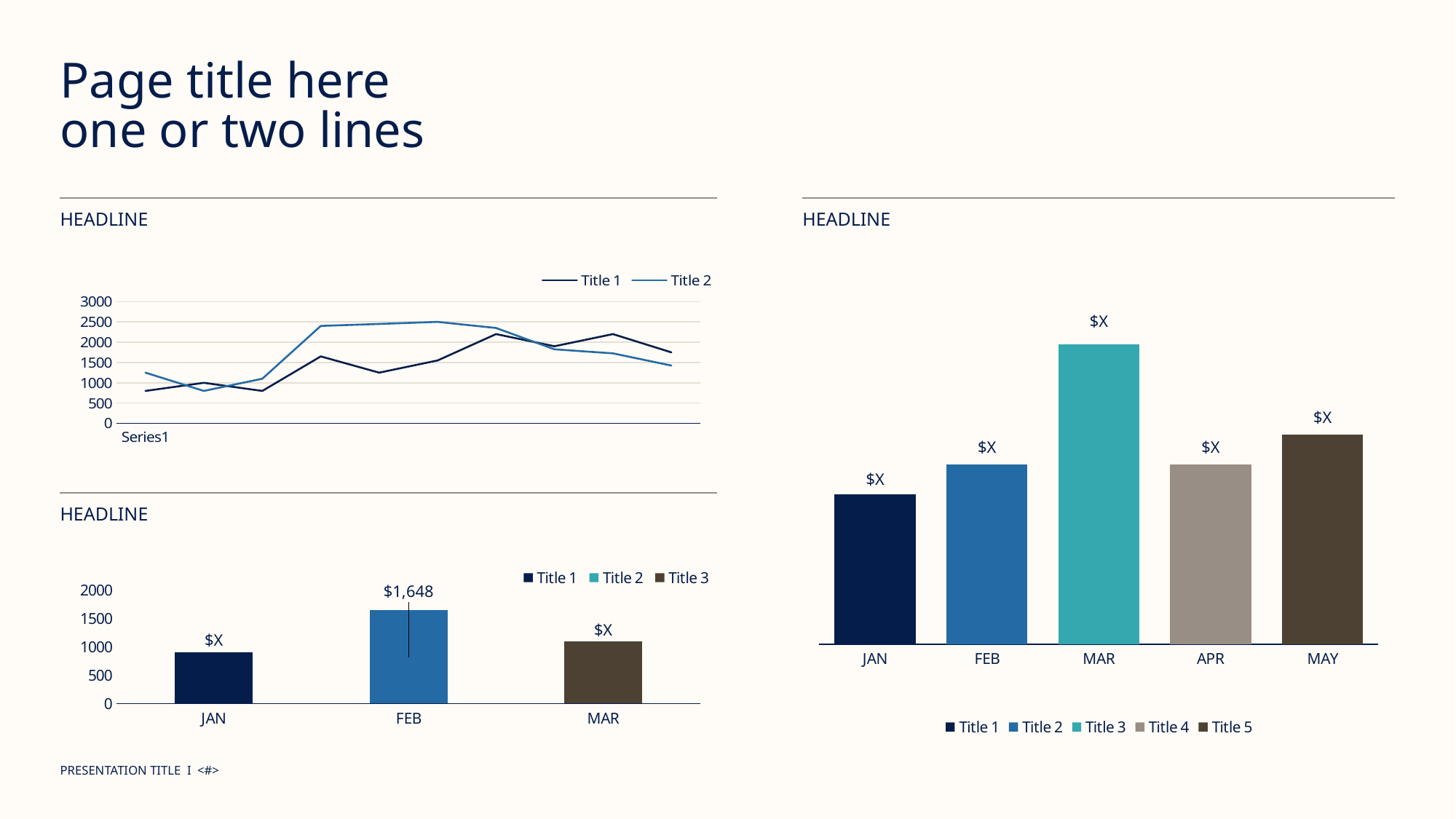
In the bottom-left bar chart, which category has the highest bar? FEB In the bottom-left bar chart, what is the value for FEB? $1,648 In the right-hand bar chart, which month has the shortest bar? JAN How many categories are shown on the x axis of the bottom-left bar chart? 3 What is the highest value shown on the y axis of the top-left line chart? 3000 In the right-hand bar chart, which month has the tallest bar? MAR How many series does the legend of the top-left line chart list? 2 What kind of chart is the chart on the right side of the slide? bar chart How many series does the legend of the right-hand bar chart list? 5 What kind of chart is the top-left chart? line chart